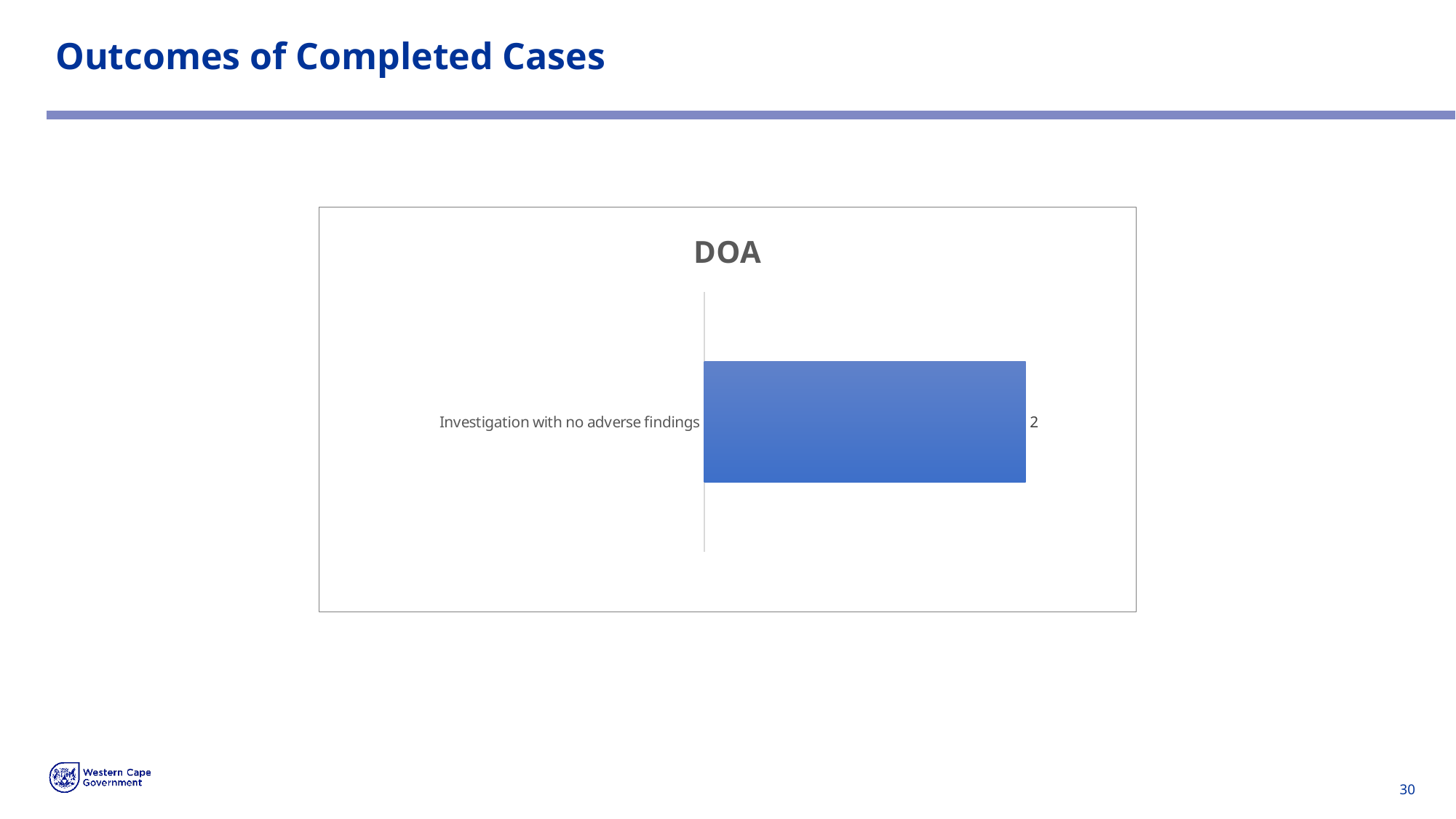
What is the title of the chart? DOA How many categories are plotted in the chart? 1 What is the label of the only category shown in the chart? Investigation with no adverse findings Which category has the highest value in the chart? Investigation with no adverse findings What is the value for Investigation with no adverse findings? 2 What kind of chart is shown on the slide? bar chart